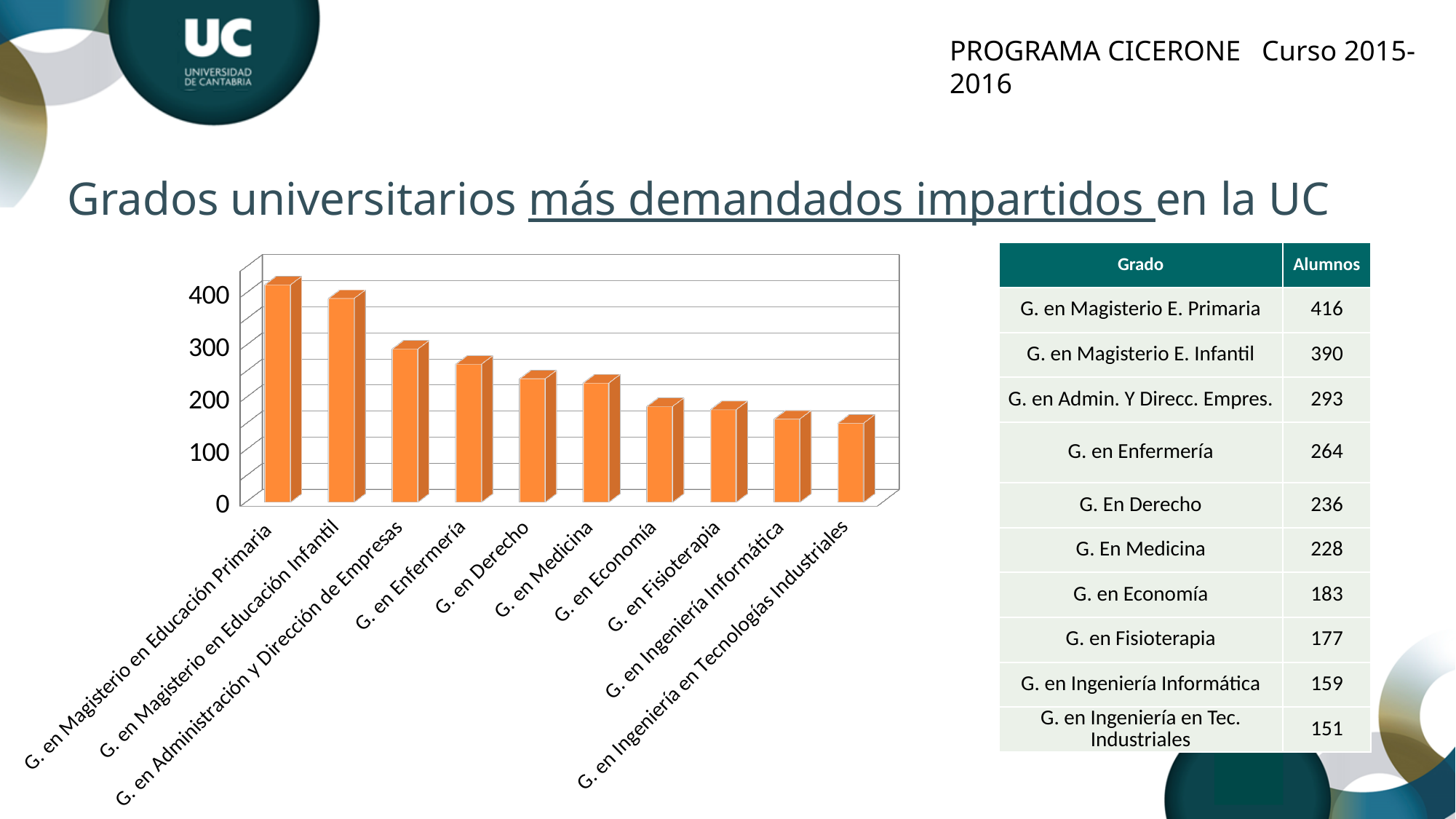
What kind of chart is shown on the slide? bar chart Which has more students, G. en Derecho or G. en Economía? G. en Derecho How many degree programmes (categories) are plotted in the bar chart? 10 Do the bar values rise or fall from left to right along the x axis? fall Is the value for G. en Administración y Dirección de Empresas greater or less than 200? greater What is the difference in students between G. en Magisterio E. Primaria (416) and G. en Magisterio E. Infantil (390)? 26 Which degree programme has the lowest number of students in the chart? G. en Ingeniería en Tecnologías Industriales How many students (Alumnos) does G. en Magisterio E. Primaria have according to the slide? 416 Is the value for G. en Ingeniería Informática greater or less than 200? less How many students (Alumnos) does G. en Fisioterapia have according to the slide? 177 How many students (Alumnos) does G. en Enfermería have according to the slide? 264 Which degree programme has the highest number of students in the chart? G. en Magisterio en Educación Primaria